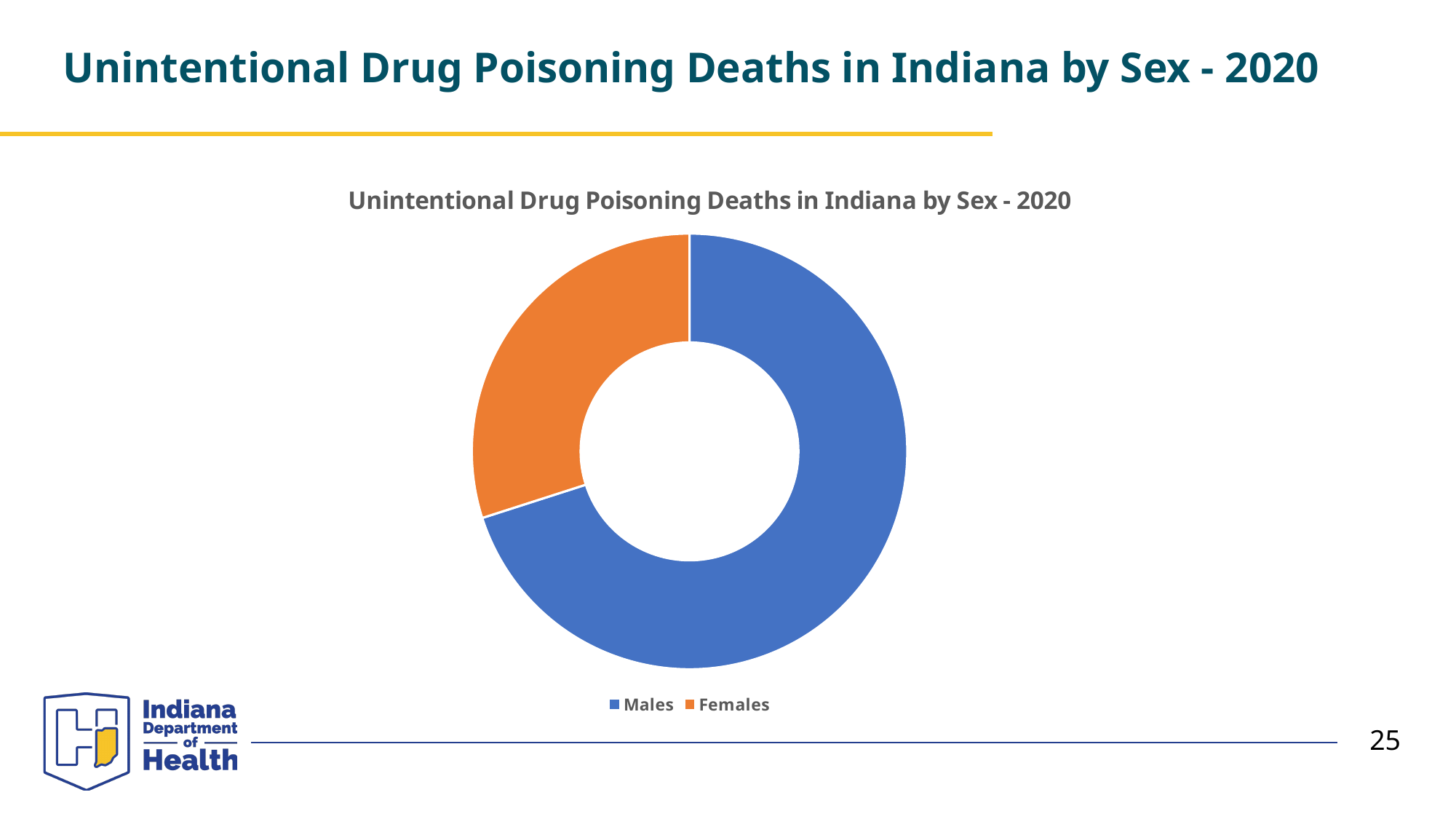
Which category has the smallest share of the chart? Females Which is larger, the share for Males or the share for Females? Males Which categories are listed in the legend? Males, Females What is the title of the chart? Unintentional Drug Poisoning Deaths in Indiana by Sex - 2020 Which category has the largest share of the chart? Males How many categories does the chart show? 2 What colour represents Females in the chart? Orange What kind of chart is shown on the slide? Pie chart (doughnut)